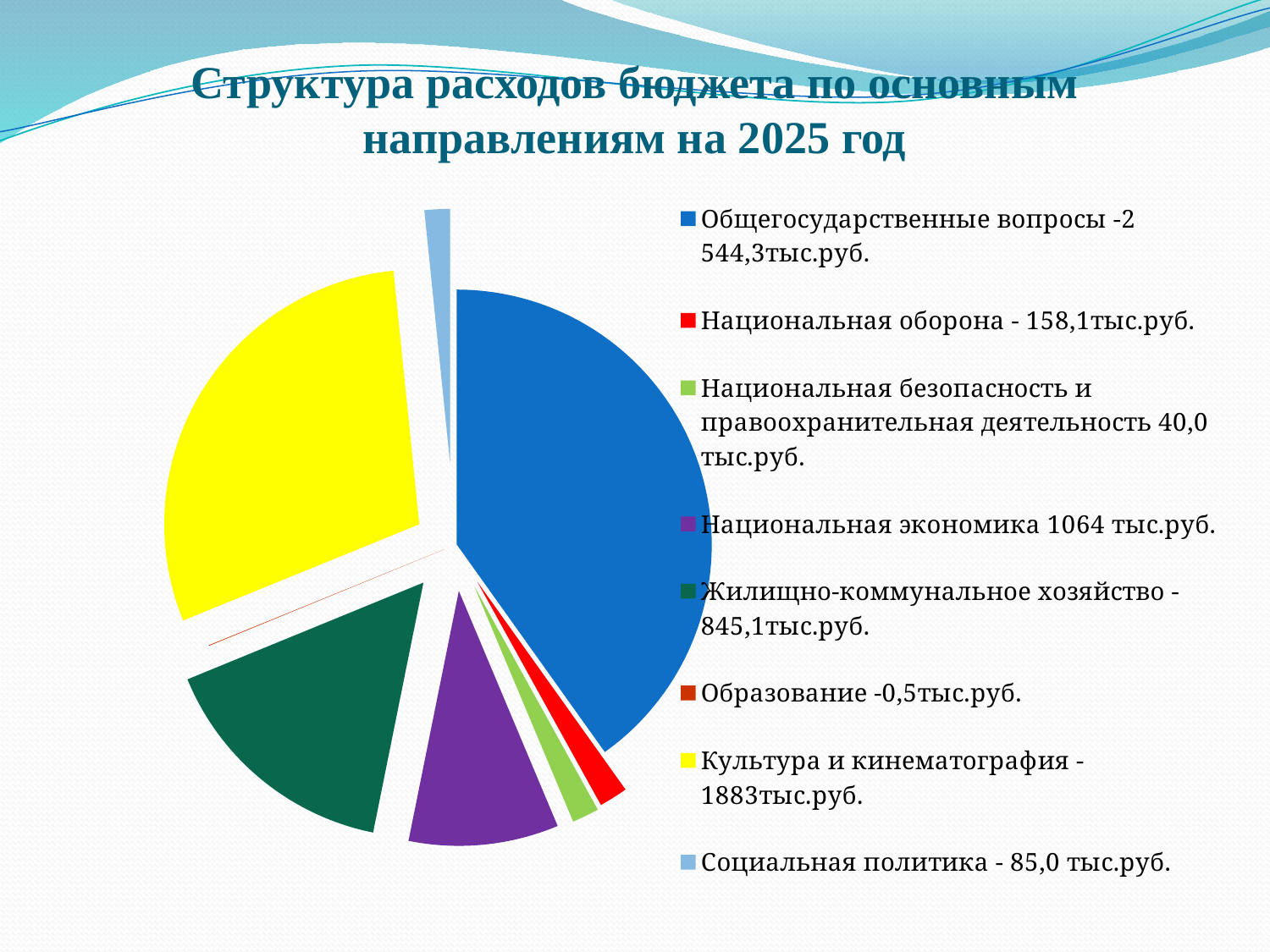
What is the value for Национальная оборона? 158,1 тыс.руб. What colour is the slice for Культура и кинематография? yellow Which category has the largest share of the pie? Общегосударственные вопросы What is the value for Культура и кинематография? 1883 тыс.руб. What is the difference between Национальная оборона and Социальная политика? 73,1 тыс.руб. What is the value for Общегосударственные вопросы? 2 544,3 тыс.руб. What kind of chart is shown on the slide? pie chart How many categories does the pie chart show? 8 Which category has the smallest value? Образование What is the difference between Культура и кинематография and Национальная экономика? 819 тыс.руб. What is the value for Социальная политика? 85,0 тыс.руб.